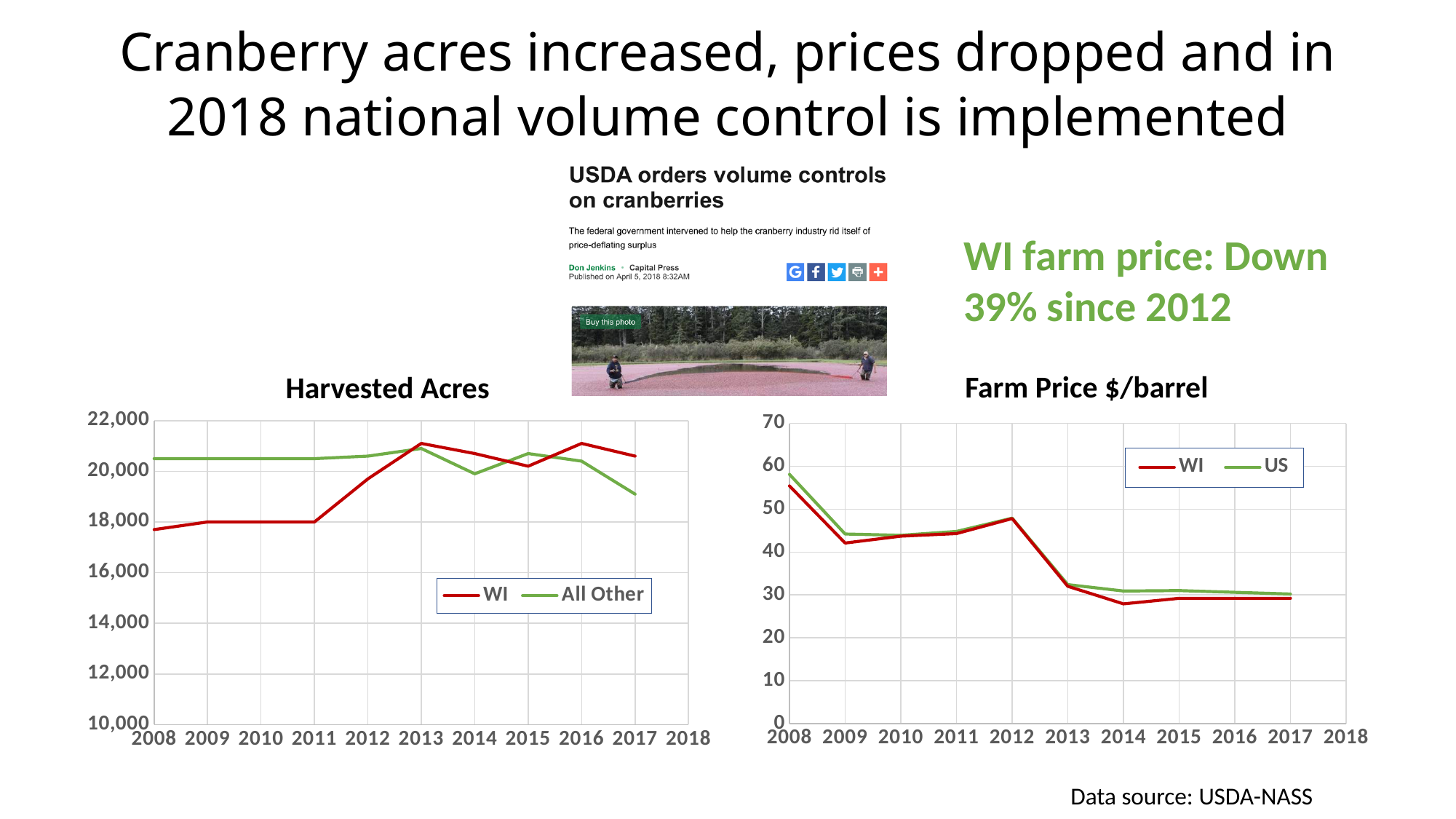
In the Farm Price $/barrel chart, which series is higher in 2014, WI or US? US How many series does the legend of the Farm Price $/barrel chart list? 2 In the Harvested Acres chart, which series is higher in 2017, WI or All Other? WI In the Harvested Acres chart, is the All Other value for 2017 greater or less than 20,000? less In the Farm Price $/barrel chart, is the WI value for 2014 greater or less than 30? less In the Harvested Acres chart, which two series does the legend list? WI and All Other What kind of chart is the Harvested Acres chart? line chart In the Harvested Acres chart, is the WI value for 2008 greater or less than 18,000? less In the Harvested Acres chart, which series is higher in 2008, WI or All Other? All Other In the Farm Price $/barrel chart, does the WI line overall rise or fall from 2008 to 2017? fall